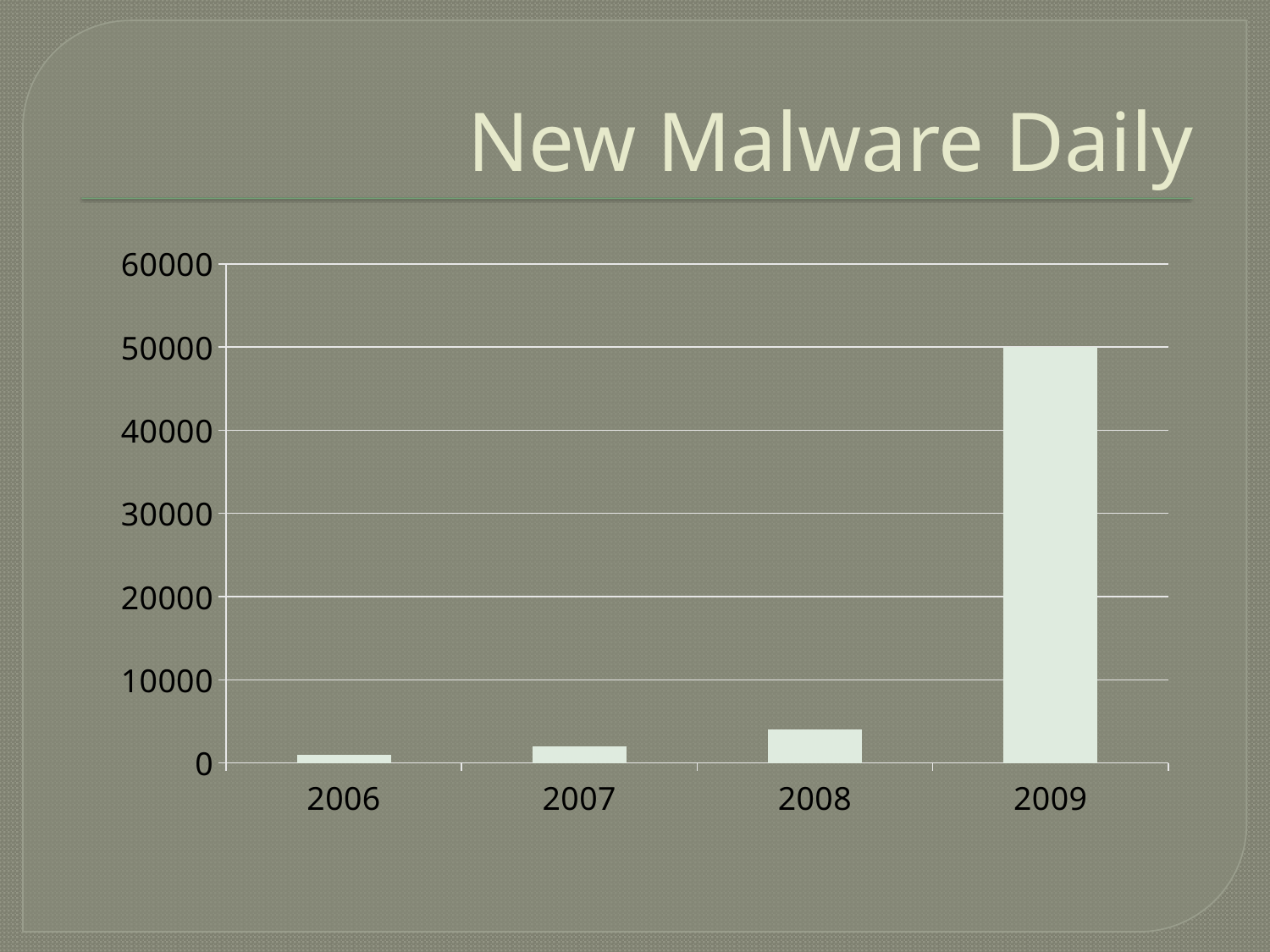
Which year has the highest value in the chart? 2009 Is the value for 2006 greater or less than 10000? less Which is larger, the value for 2007 or the value for 2008? 2008 What is the value for 2009? 50000 What kind of chart is shown on the slide? bar chart Is the value for 2009 greater or less than 40000? greater How many years are shown on the x axis of the chart? 4 Which year has the lowest value in the chart? 2006 What is the highest value shown on the vertical axis of the chart? 60000 Is the value for 2008 greater or less than 10000? less What is the title of the chart? New Malware Daily Do the values rise or fall from 2006 to 2009? rise